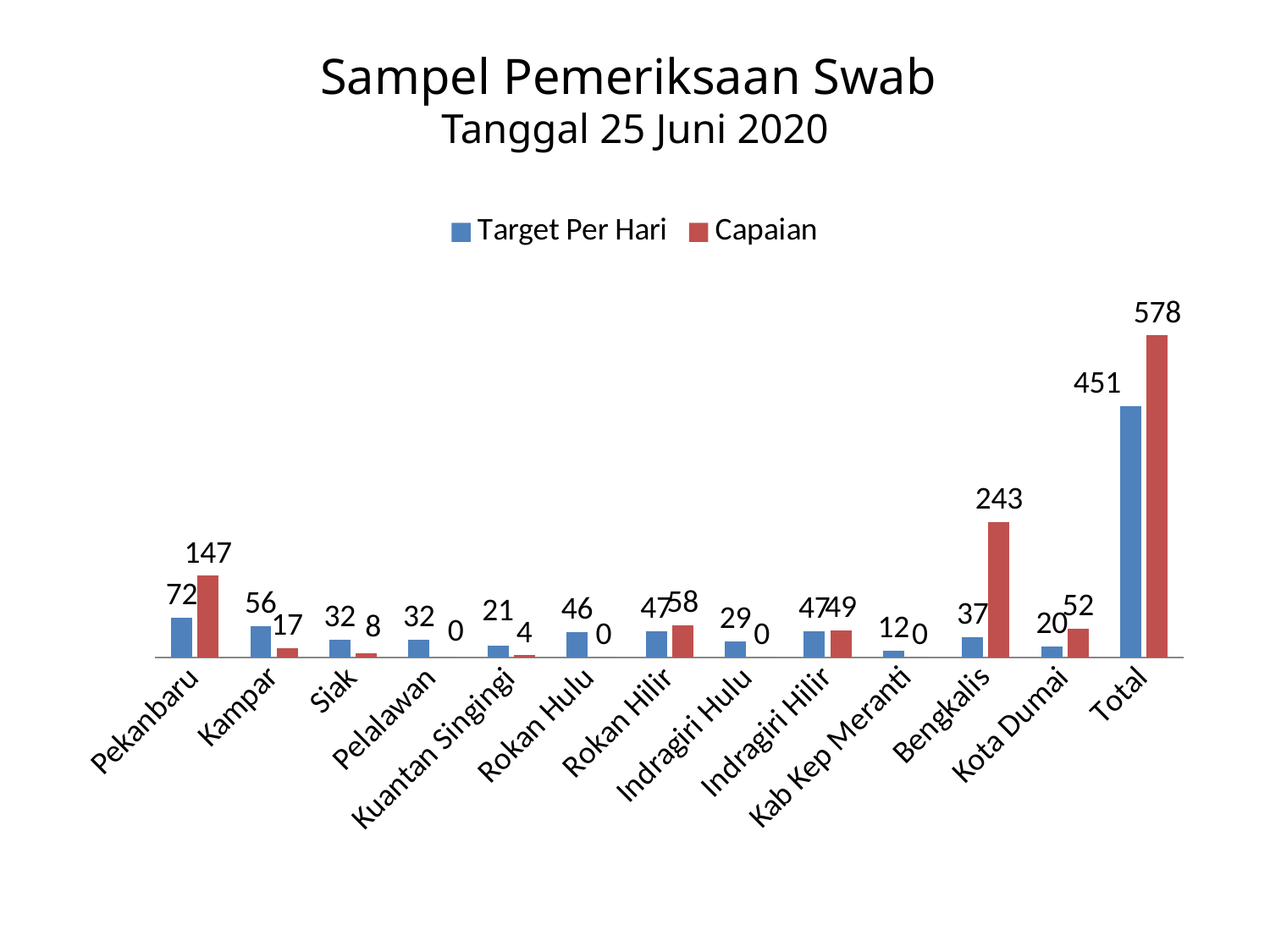
What kind of chart is shown on the slide? Bar chart What is the Target Per Hari value for Pekanbaru? 72 How many categories are shown on the x axis? 13 How many series does the legend list? 2 What is the Capaian value for Kota Dumai? 52 Excluding the Total category, which region has the lowest Target Per Hari value? Kab Kep Meranti Which is larger for Kampar, Target Per Hari or Capaian? Target Per Hari What is the Target Per Hari value for Kab Kep Meranti? 12 What is the Capaian value for Bengkalis? 243 What is the difference between the Capaian and Target Per Hari values for Total? 127 What is the difference between the Capaian and Target Per Hari values for Pekanbaru? 75 Excluding the Total category, which region has the highest Capaian value? Bengkalis